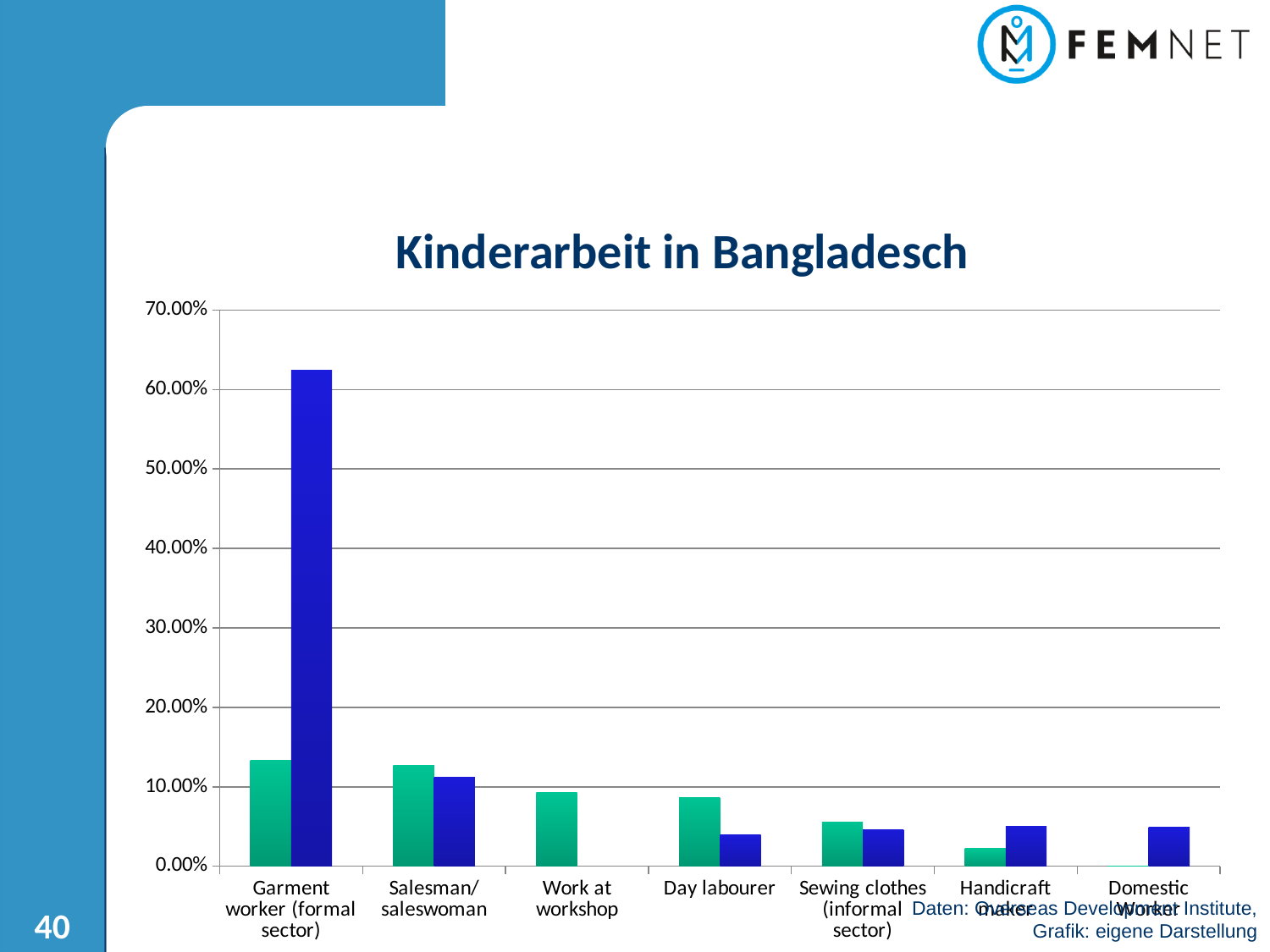
Is the blue bar for Day labourer greater or less than 10.00%? less What is the title of the chart? Kinderarbeit in Bangladesch What is the highest value shown on the y axis? 70.00% Which category has the tallest bar in the chart? Garment worker (formal sector) For Salesman/saleswoman, which bar is taller, the green one or the blue one? green What kind of chart is shown on the slide? bar chart Which category has no blue bar at all? Work at workshop Is the green bar for Garment worker (formal sector) greater or less than 10.00%? greater For Handicraft maker, which bar is taller, the green one or the blue one? blue Is the green bar for Work at workshop greater or less than 10.00%? less How many categories are shown on the x axis of the chart? 7